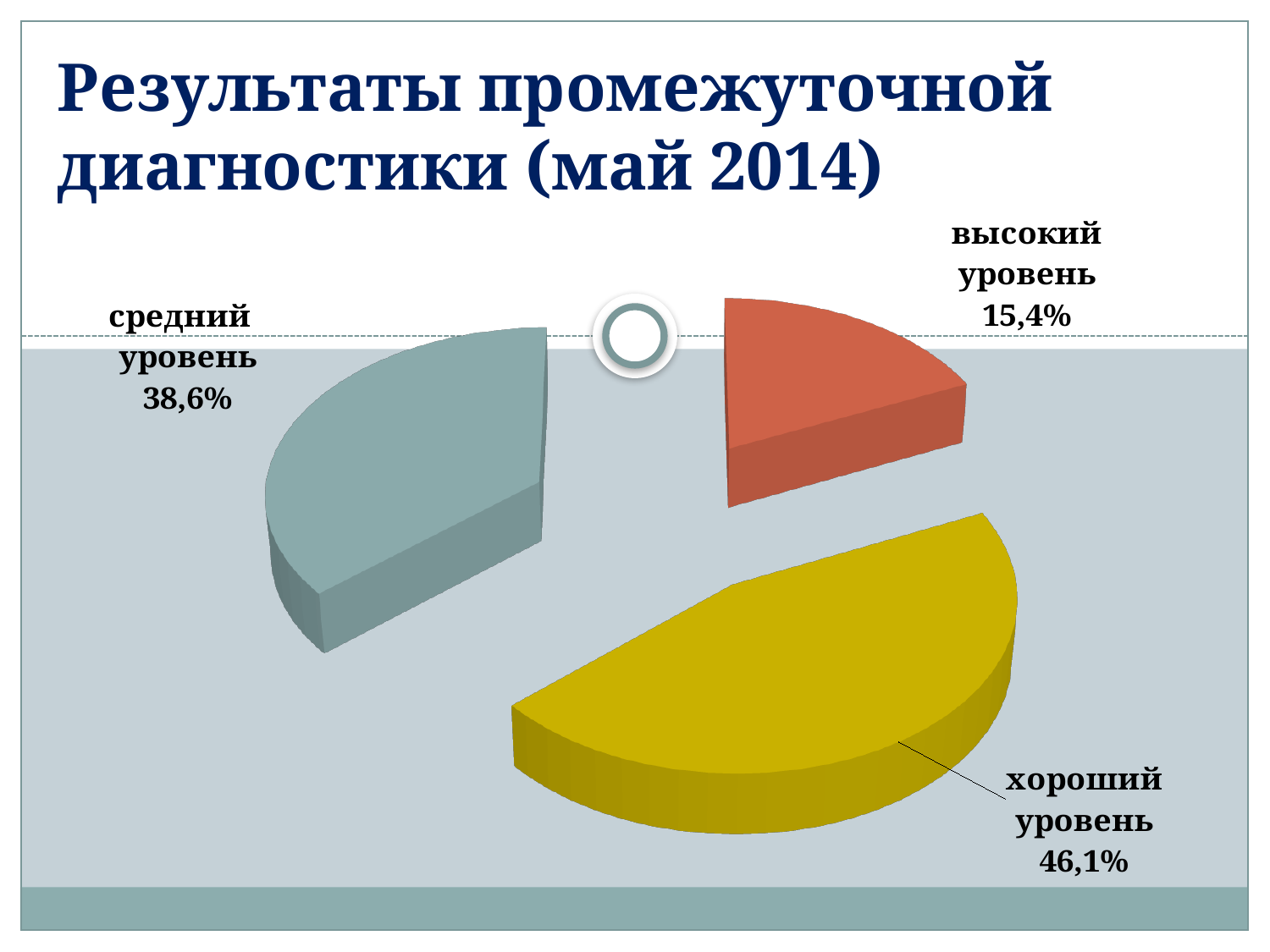
What is the title of the slide containing the chart? Результаты промежуточной диагностики (май 2014) What colour is the slice for "хороший уровень"? yellow How many slices does the pie chart have? 3 What is the difference between the values for "средний уровень" and "высокий уровень"? 23,2% What is the value for "высокий уровень"? 15,4% What is the difference between the values for "хороший уровень" and "средний уровень"? 7,5% What type of chart is shown on the slide? pie chart Which category has the smallest share of the pie? высокий уровень Which category has the largest share of the pie? хороший уровень Which is larger, the value for "средний уровень" or the value for "высокий уровень"? средний уровень What is the value for "хороший уровень"? 46,1% What is the value for "средний уровень"? 38,6%